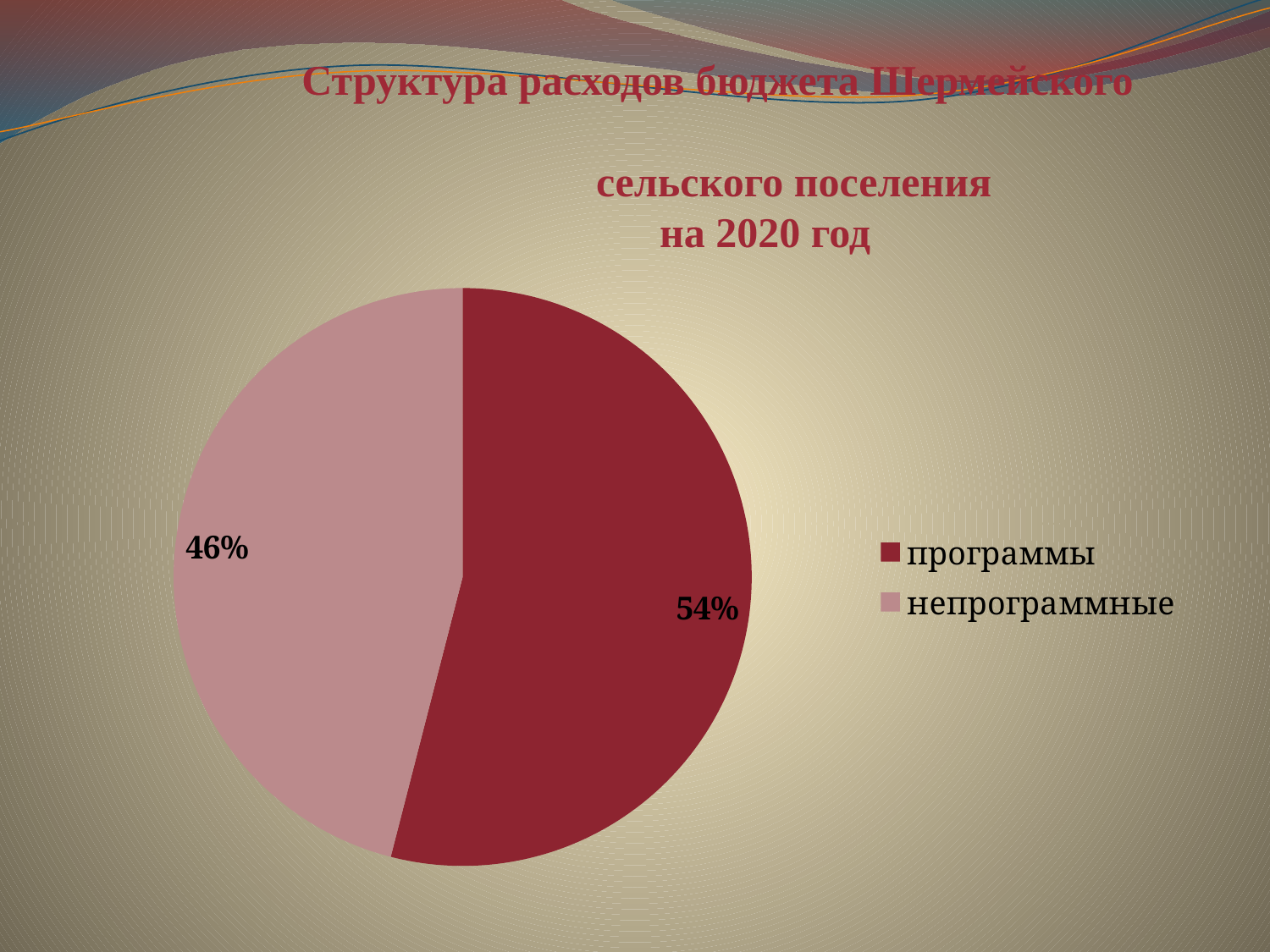
Which category has the smallest share of the pie? непрограммные What is the difference in percentage points between "программы" and "непрограммные"? 8 How many entries does the legend list? 2 Which category has the largest share of the pie? программы What share of the pie does "непрограммные" have? 46% Which colour represents "непрограммные" in the pie chart? light pink What share of the pie does "программы" have? 54% How many slices does the pie chart have? 2 What year does the chart title refer to? 2020 What kind of chart is shown on the slide? pie chart Which is larger, the share for "программы" or the share for "непрограммные"? программы